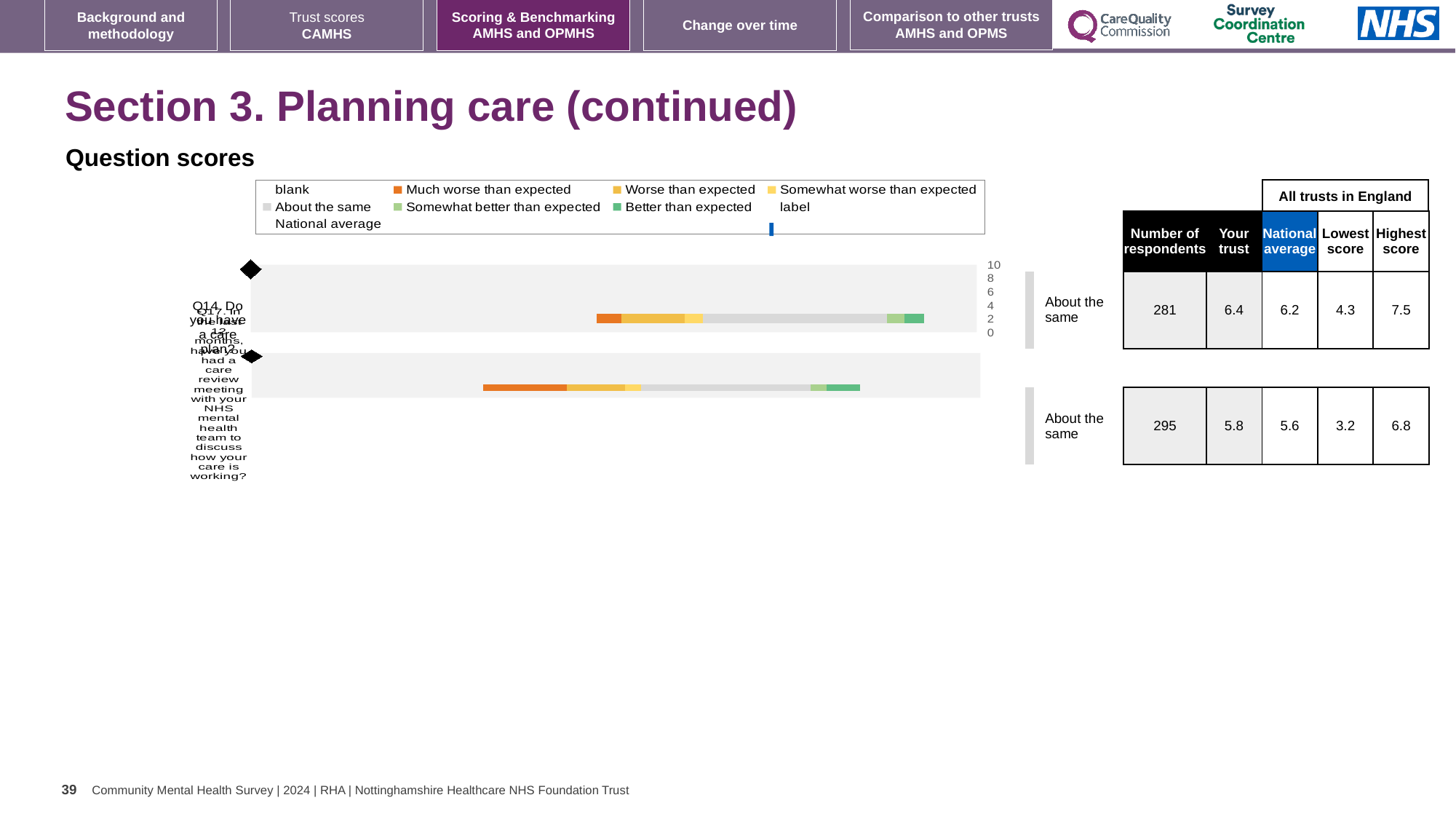
For the first row (Q14), which is larger: the 'Your trust' score or the national average? Your trust Which of the two rows has the higher 'Your trust' score? Q14 In the table beside the chart, what is the lowest score for the second row (Q17)? 3.2 What benchmark category is shown next to the second bar (Q17)? About the same In the chart legend, which category is shown in dark green? Better than expected In the chart legend, which colour represents 'Much worse than expected'? orange How many questions (bars) are plotted in the chart? 2 In the table beside the chart, what is the 'Your trust' score for the first row (Q14)? 6.4 What kind of chart is shown under 'Question scores'? bar chart In the table beside the chart, how many respondents are listed for the first row (Q14)? 281 For the first row (Q14), what is the difference between the highest score and the lowest score in the table? 3.2 In the table beside the chart, what is the national average for the second row (Q17)? 5.6